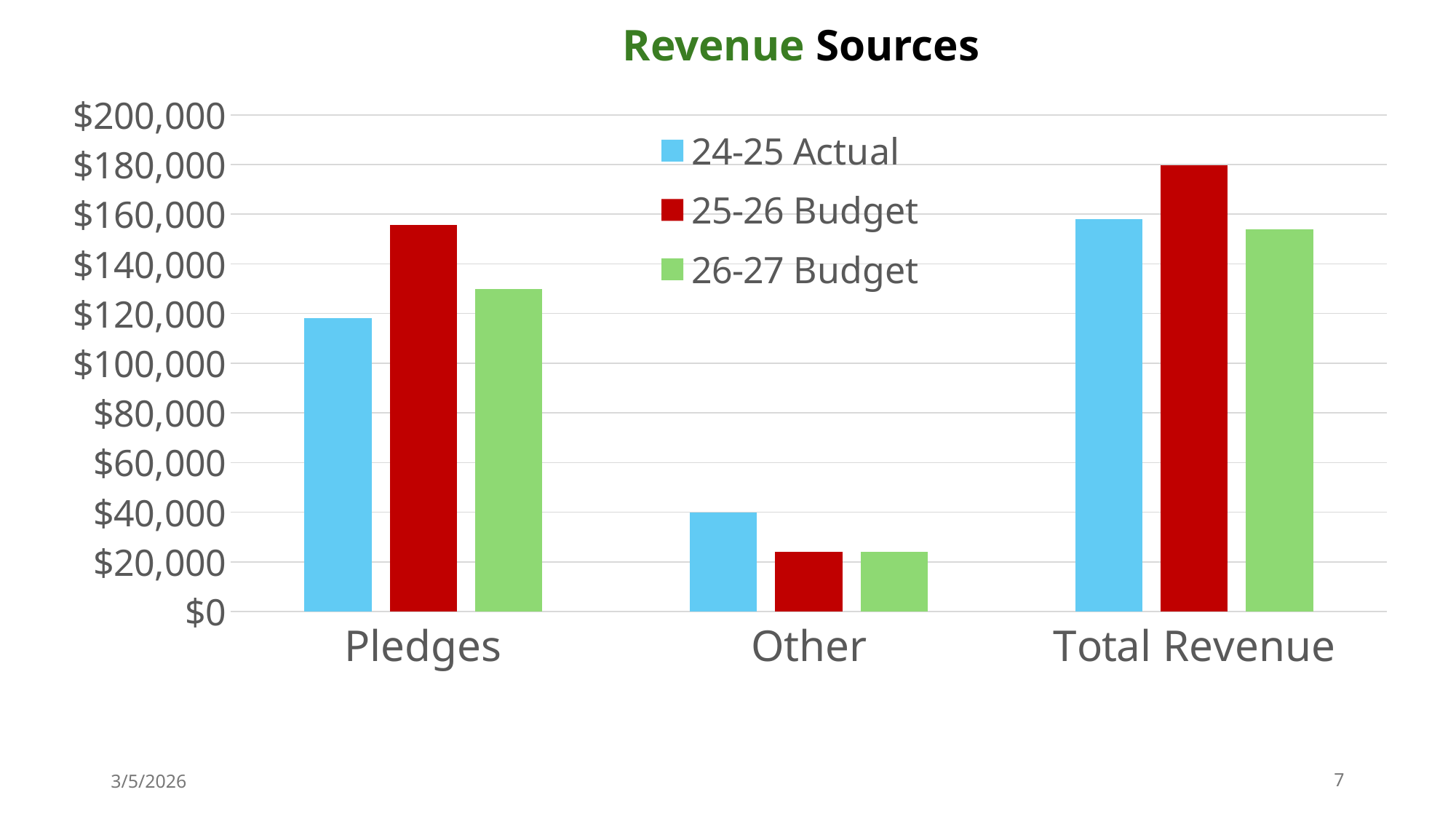
Is the 24-25 Actual value for Other greater or less than $60,000? less Is the 24-25 Actual value for Pledges greater or less than $100,000? greater How many series does the legend list? 3 Is the 25-26 Budget value for Total Revenue greater or less than $160,000? greater What kind of chart is shown on the slide? bar chart What is the title of the chart? Revenue Sources Which category has the lowest 24-25 Actual value? Other How many categories are shown on the x axis? 3 For Pledges, which is larger: the 24-25 Actual value or the 26-27 Budget value? 26-27 Budget Which series has the highest value for Pledges? 25-26 Budget